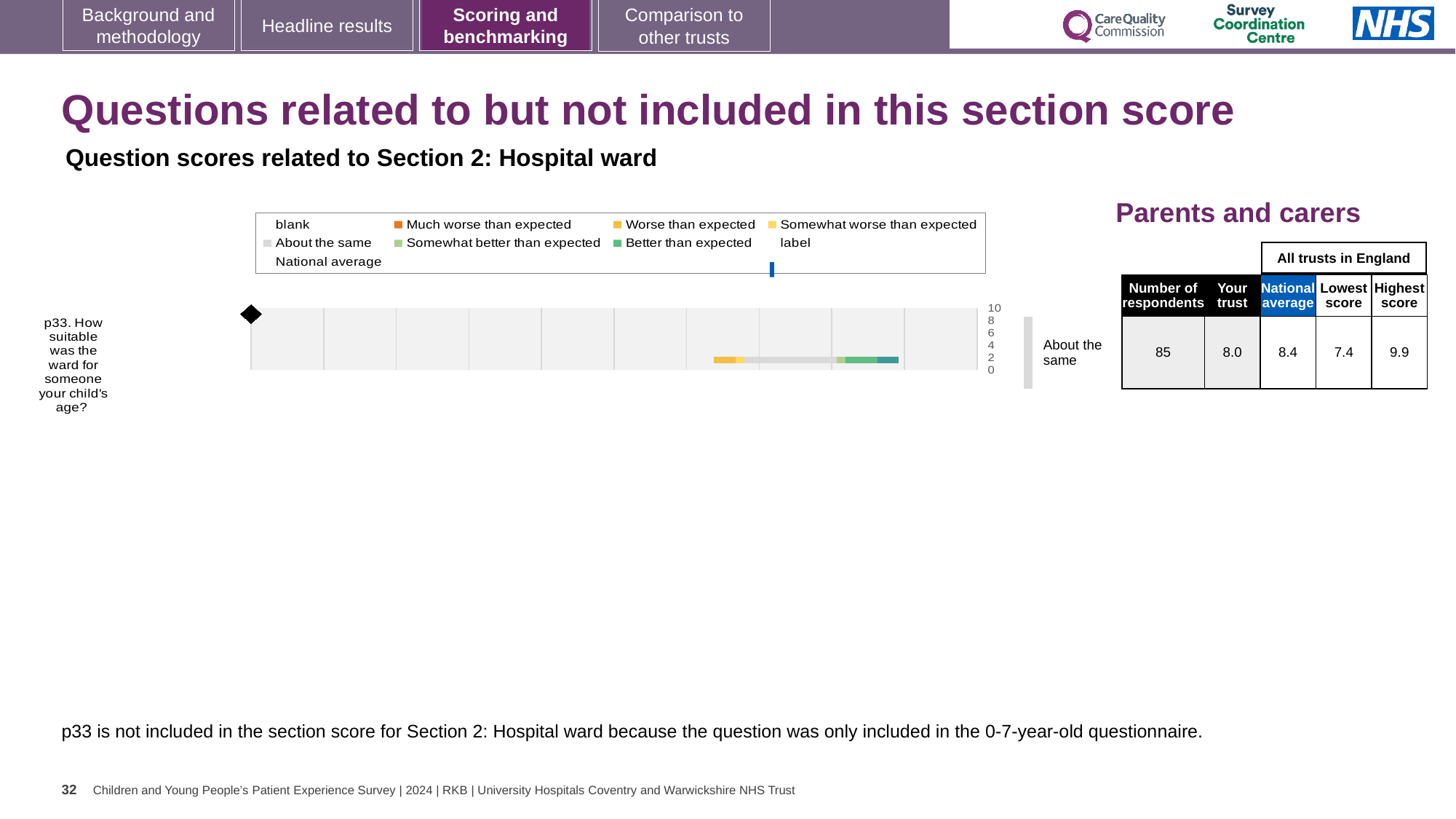
What is the difference between the highest and lowest trust scores for question p33? 2.5 How is the trust's result for question p33 categorised relative to expectations? About the same What is the national average score for question p33? 8.4 What is the lowest score among all trusts in England for question p33? 7.4 What is the highest score among all trusts in England for question p33? 9.9 How many questions are plotted in the chart? 1 Which respondent group does the chart relate to, according to the heading above the table? Parents and carers What is the trust's score for question p33 (How suitable was the ward for someone your child's age)? 8.0 What is the difference between the national average and the trust's score for question p33? 0.4 What kind of chart is used to show the p33 benchmarking result? Bar chart Which is larger for question p33: the trust's score or the national average? National average How many respondents answered question p33? 85